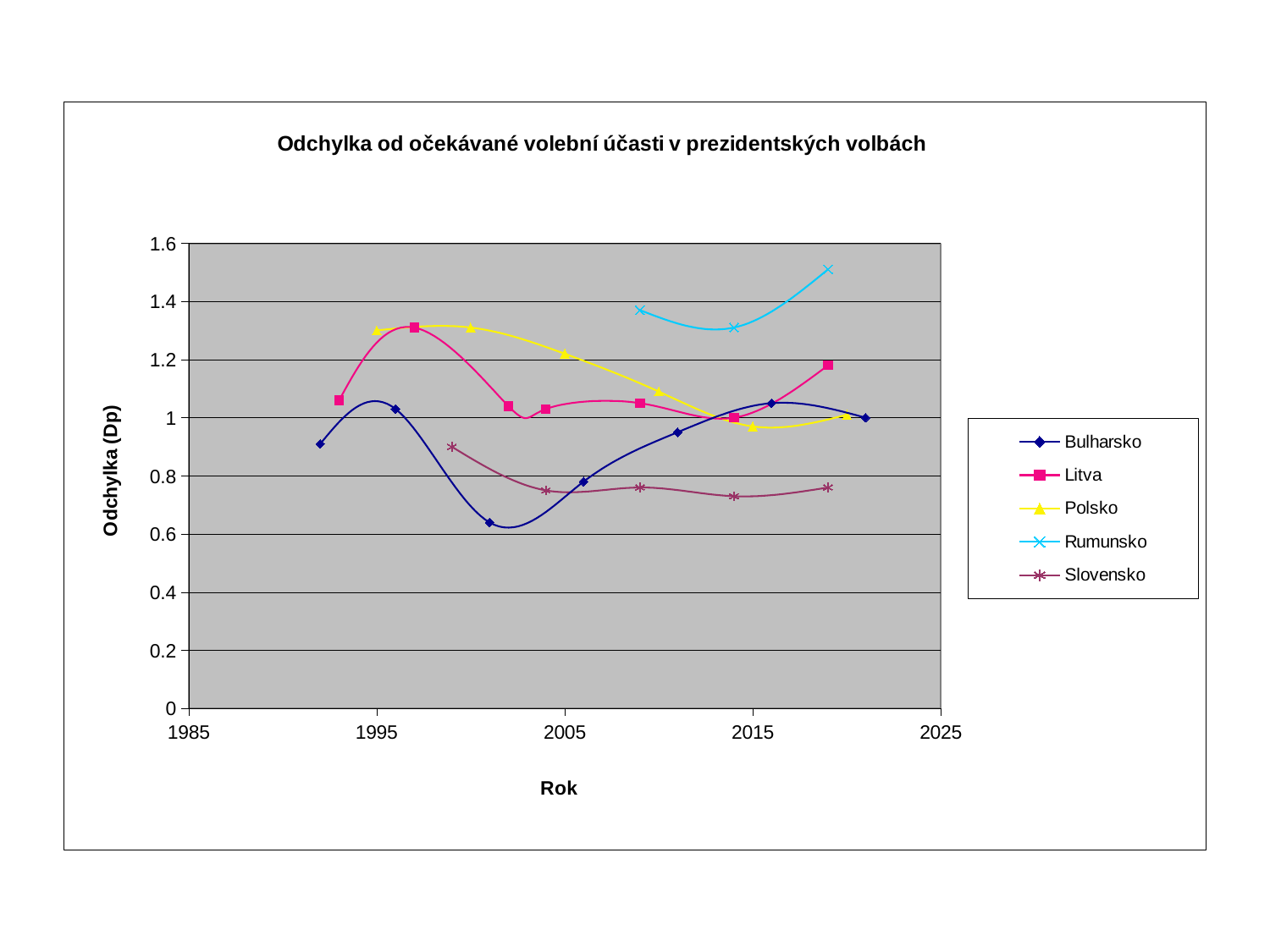
How many data points are plotted for Rumunsko? 3 Do the values for Rumunsko rise or fall between its middle point and its last point? rise What is the title of the chart? Odchylka od očekávané volební účasti v prezidentských volbách Which series reaches the highest value on the chart? Rumunsko Which series has the lowest point on the chart? Bulharsko How many data points are plotted for Slovensko? 5 Is the last (rightmost) value for Rumunsko greater or less than 1.4? greater What kind of chart is shown on the slide? line chart Is the first (leftmost) value for Polsko greater or less than 1.2? greater Is the lowest value for Bulharsko greater or less than 0.8? less What is the label of the x axis? Rok How many series does the legend list? 5